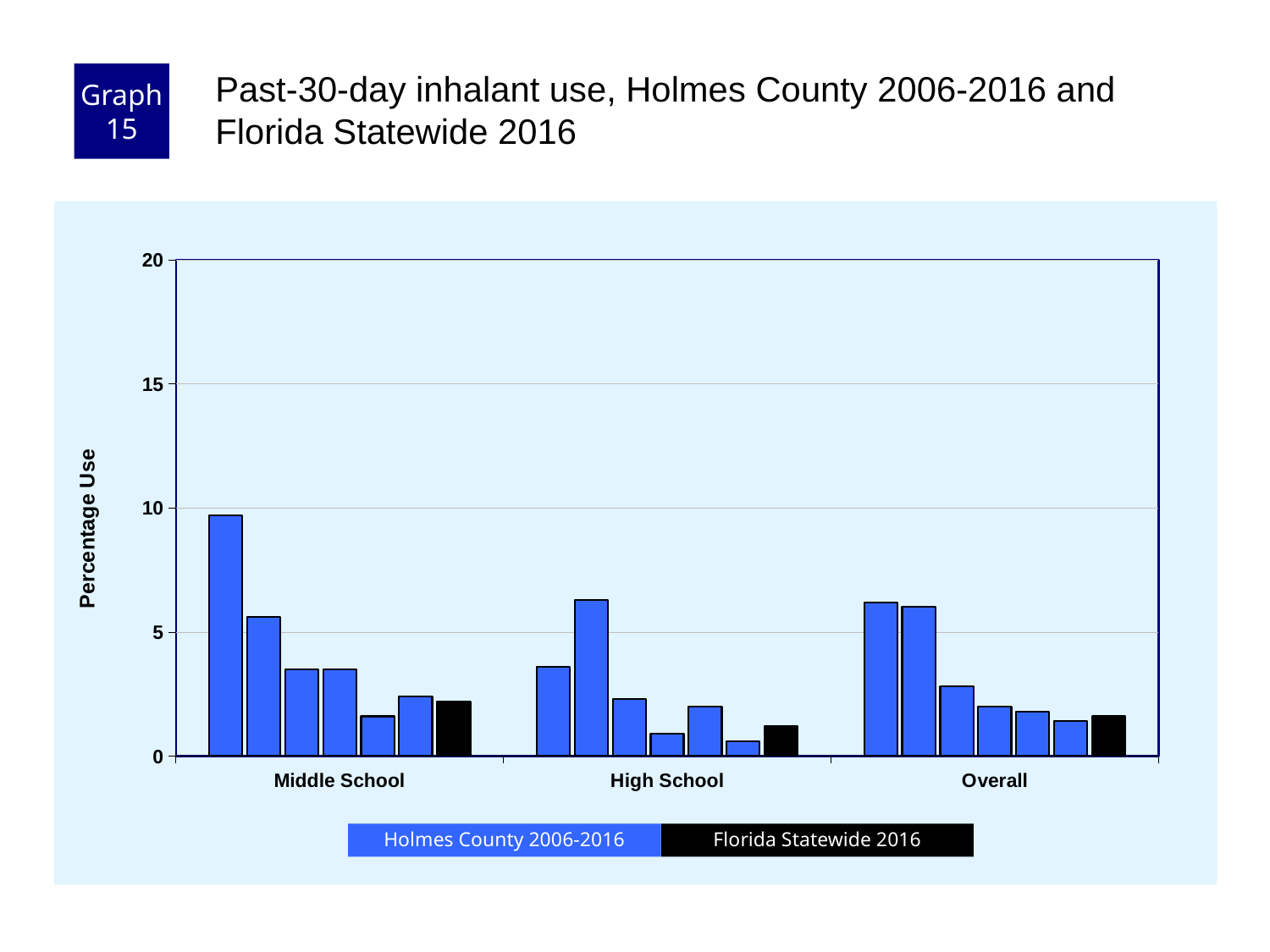
What colour represents Florida Statewide 2016 in the legend? black How many category groups are shown on the x axis? 3 Is the Florida Statewide 2016 value for High School greater or less than 5? less Is the tallest Middle School bar greater or less than 5? greater Is the tallest High School bar greater or less than 5? greater How many series does the legend list? 2 What kind of chart is shown on the slide? bar chart Which is larger, the Florida Statewide 2016 value for Middle School or for High School? Middle School What is the title of the y axis? Percentage Use Which category group contains the tallest bar on the chart? Middle School How many Holmes County 2006-2016 bars are shown in each category group? 6